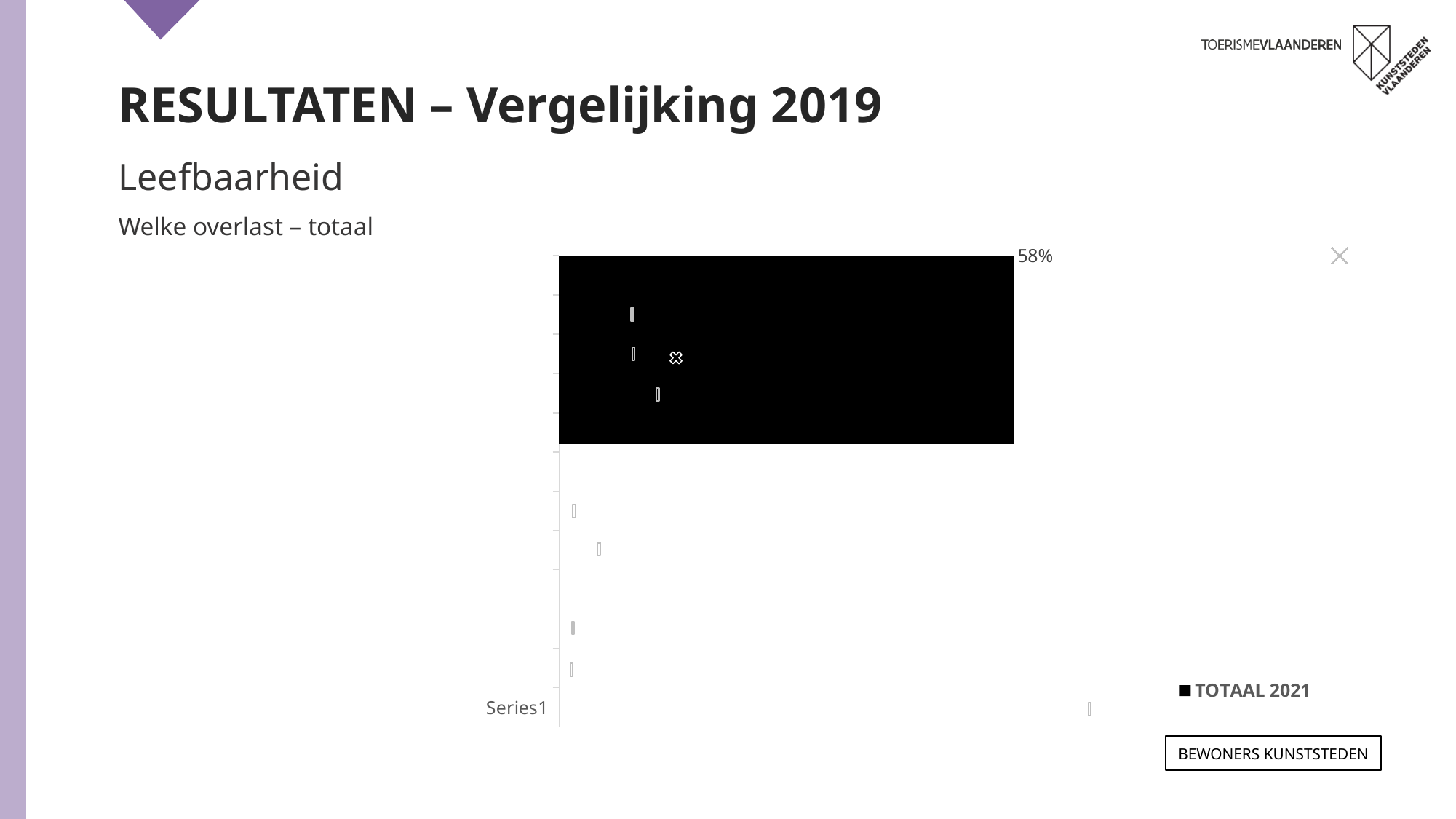
What value is printed next to the longest bar in the chart? 58% What kind of chart is shown on the slide? bar chart What is the highest value shown by a data label on the chart? 58% Is the value of the longest bar greater or less than 50%? greater How many series does the chart legend list? 1 What is the name of the series listed in the chart legend? TOTAAL 2021 What colour are the bars for the TOTAAL 2021 series? black